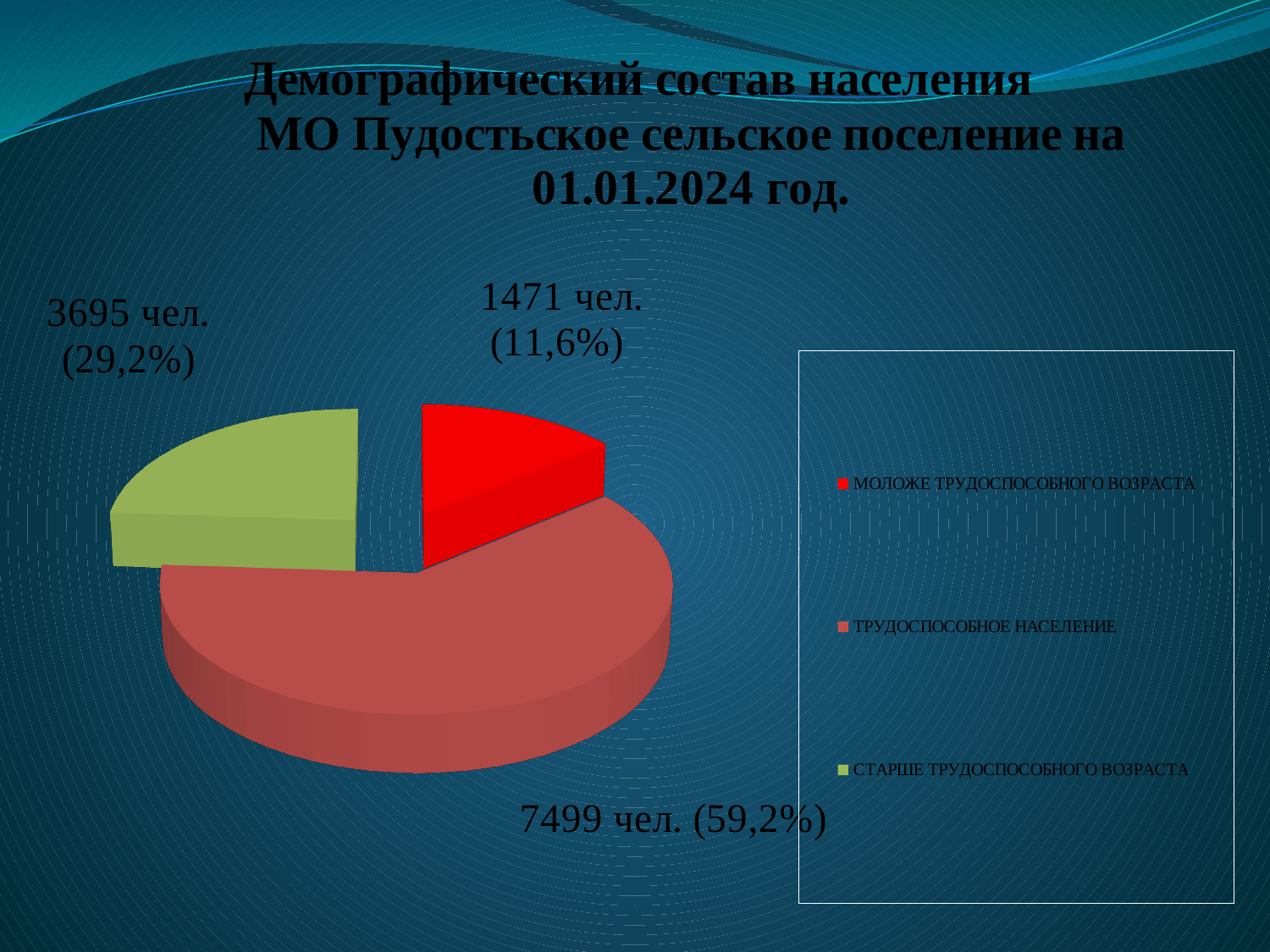
Which category has the largest slice of the pie? ТРУДОСПОСОБНОЕ НАСЕЛЕНИЕ How many slices does the pie chart have? 3 What kind of chart is shown on the slide? pie chart How many people are in the МОЛОЖЕ ТРУДОСПОСОБНОГО ВОЗРАСТА category? 1471 чел. What share of the pie does the ТРУДОСПОСОБНОЕ НАСЕЛЕНИЕ slice represent? 59,2% What share of the pie does the СТАРШЕ ТРУДОСПОСОБНОГО ВОЗРАСТА slice represent? 29,2% What is the difference in people between the СТАРШЕ ТРУДОСПОСОБНОГО ВОЗРАСТА and МОЛОЖЕ ТРУДОСПОСОБНОГО ВОЗРАСТА categories? 2224 чел. How many people are in the ТРУДОСПОСОБНОЕ НАСЕЛЕНИЕ category? 7499 чел. Which colour represents the ТРУДОСПОСОБНОЕ НАСЕЛЕНИЕ category in the legend? pink-red How many entries does the legend list? 3 How many people are in the СТАРШЕ ТРУДОСПОСОБНОГО ВОЗРАСТА category? 3695 чел. Which category has the smallest slice of the pie? МОЛОЖЕ ТРУДОСПОСОБНОГО ВОЗРАСТА